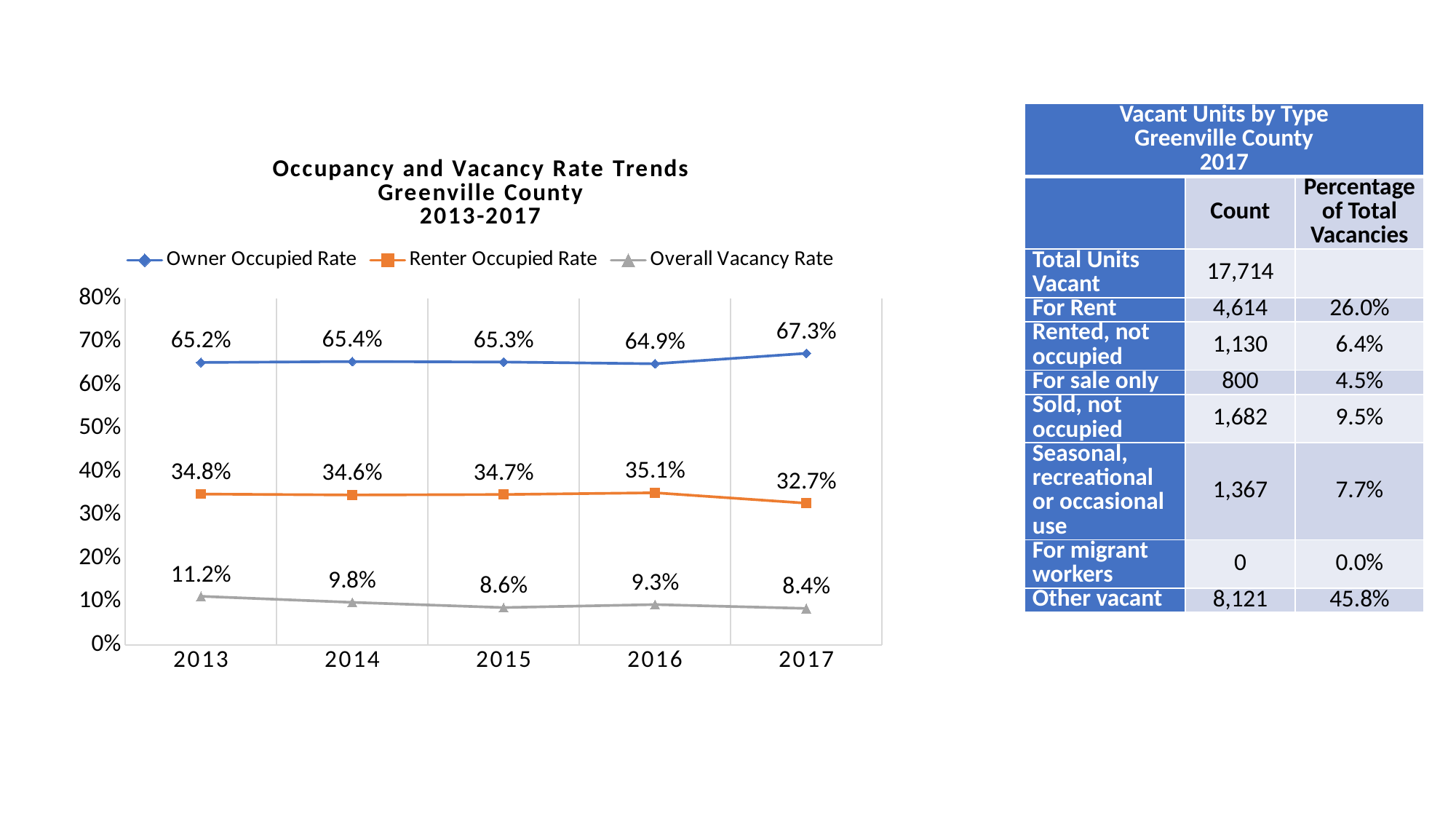
Does the Overall Vacancy Rate generally rise or fall from 2013 to 2017? fall What is the difference between the Owner Occupied Rate and the Renter Occupied Rate in 2017? 34.6% What is the Owner Occupied Rate in 2017? 67.3% What is the Overall Vacancy Rate in 2013? 11.2% What kind of chart is shown? line chart In which year is the Overall Vacancy Rate lowest? 2017 Which is larger in 2015: the Renter Occupied Rate or the Overall Vacancy Rate? Renter Occupied Rate In which year is the Owner Occupied Rate highest? 2017 What is the Renter Occupied Rate in 2016? 35.1% How many series does the legend list? 3 Is the Owner Occupied Rate in 2016 greater or less than 60%? greater How many years are plotted on the x axis? 5